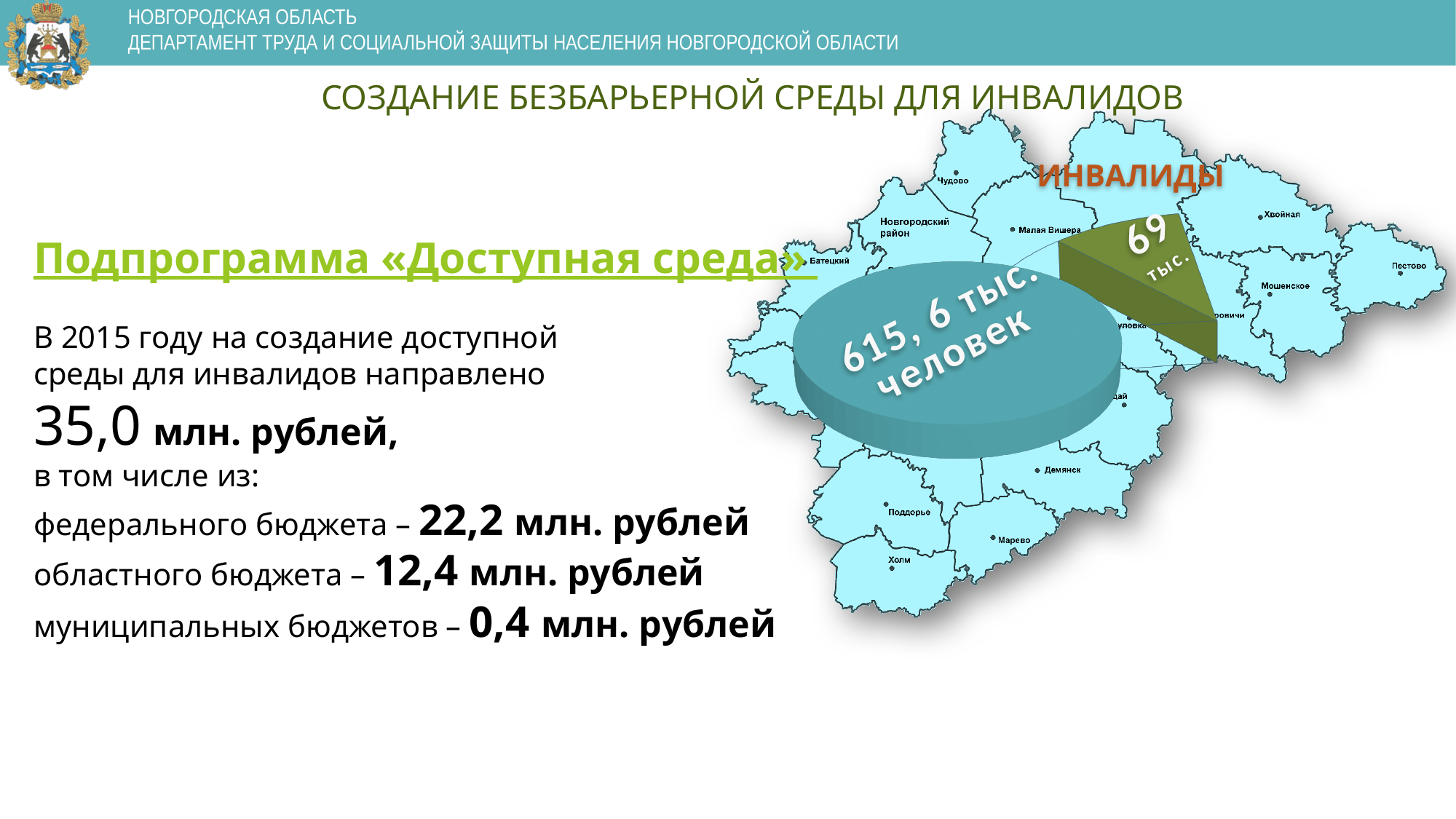
What kind of chart is shown on the map on the right side of the slide? pie chart What value is printed on the large teal slice of the pie chart? 615,6 тыс. человек What colour is the slice labelled ИНВАЛИДЫ in the pie chart? green What is the difference between the two values shown on the pie chart, 615,6 тыс. and 69 тыс.? 546,6 тыс. Which slice of the pie chart is the largest? 615,6 тыс. человек What value is printed on the small green slice of the pie chart? 69 тыс. Which is larger in the pie chart: the slice labelled 615,6 тыс. человек or the slice labelled 69 тыс.? 615,6 тыс. человек Is the value of the ИНВАЛИДЫ slice in the pie chart greater or less than 100 тыс.? less What label is placed above the green slice of the pie chart? ИНВАЛИДЫ How many slices does the pie chart on the right have? 2 Which slice of the pie chart is the smallest? 69 тыс. (ИНВАЛИДЫ)